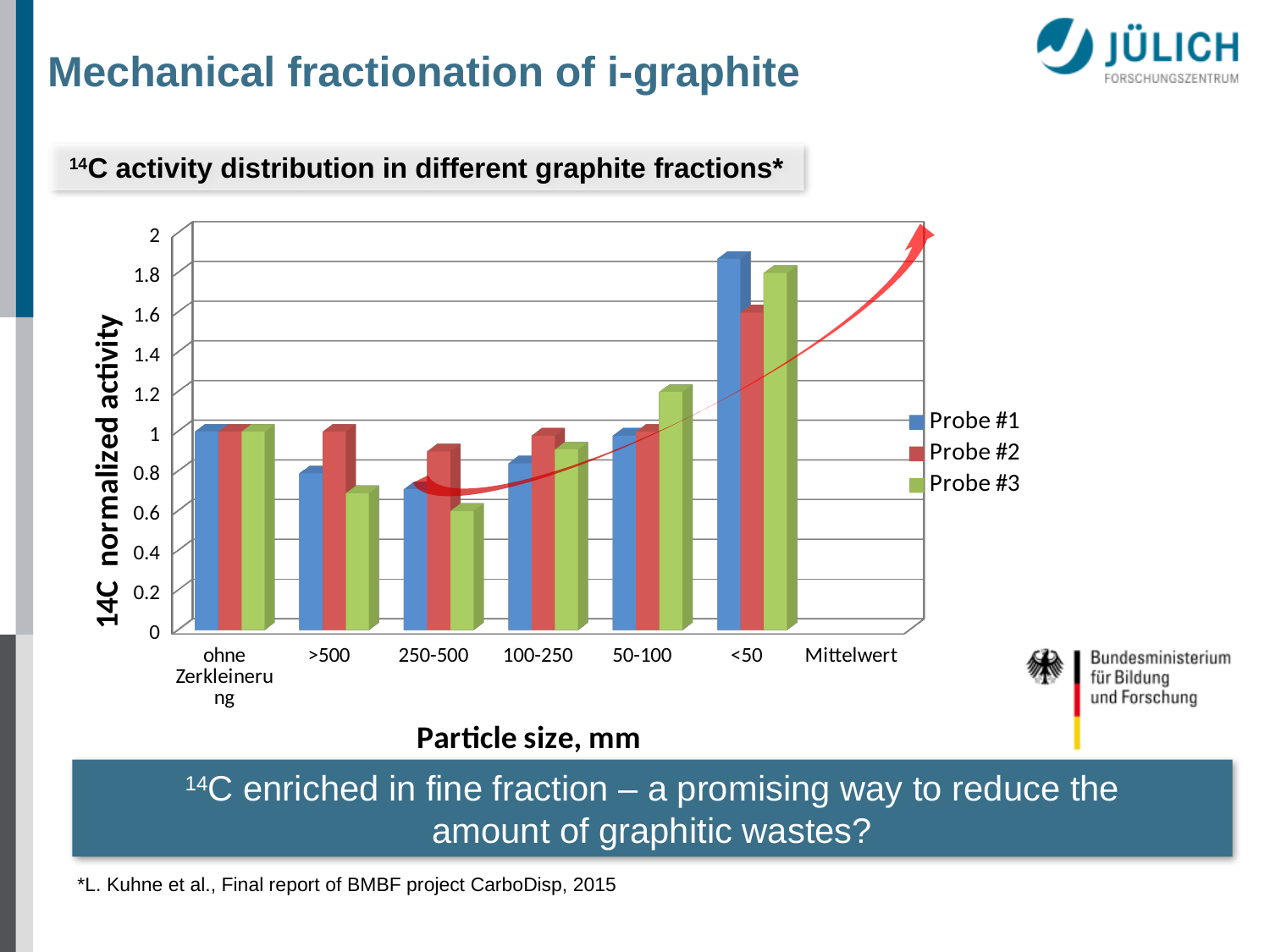
Which particle size category has the highest Probe #1 value? <50 Is the Probe #3 value for 250-500 greater or less than 0.8? less How many categories are labelled along the x axis of the chart? 7 What kind of chart is shown on the slide? bar chart Is the Probe #3 value for 50-100 greater or less than 1? greater Is the Probe #1 value for <50 greater or less than 1.6? greater Which particle size category has the lowest Probe #3 value? 250-500 How many series does the chart legend list? 3 For the 50-100 category, which is larger: Probe #1 or Probe #3? Probe #3 For the <50 category, which is larger: Probe #1 or Probe #2? Probe #1 What is the title of the x axis of the chart? Particle size, mm